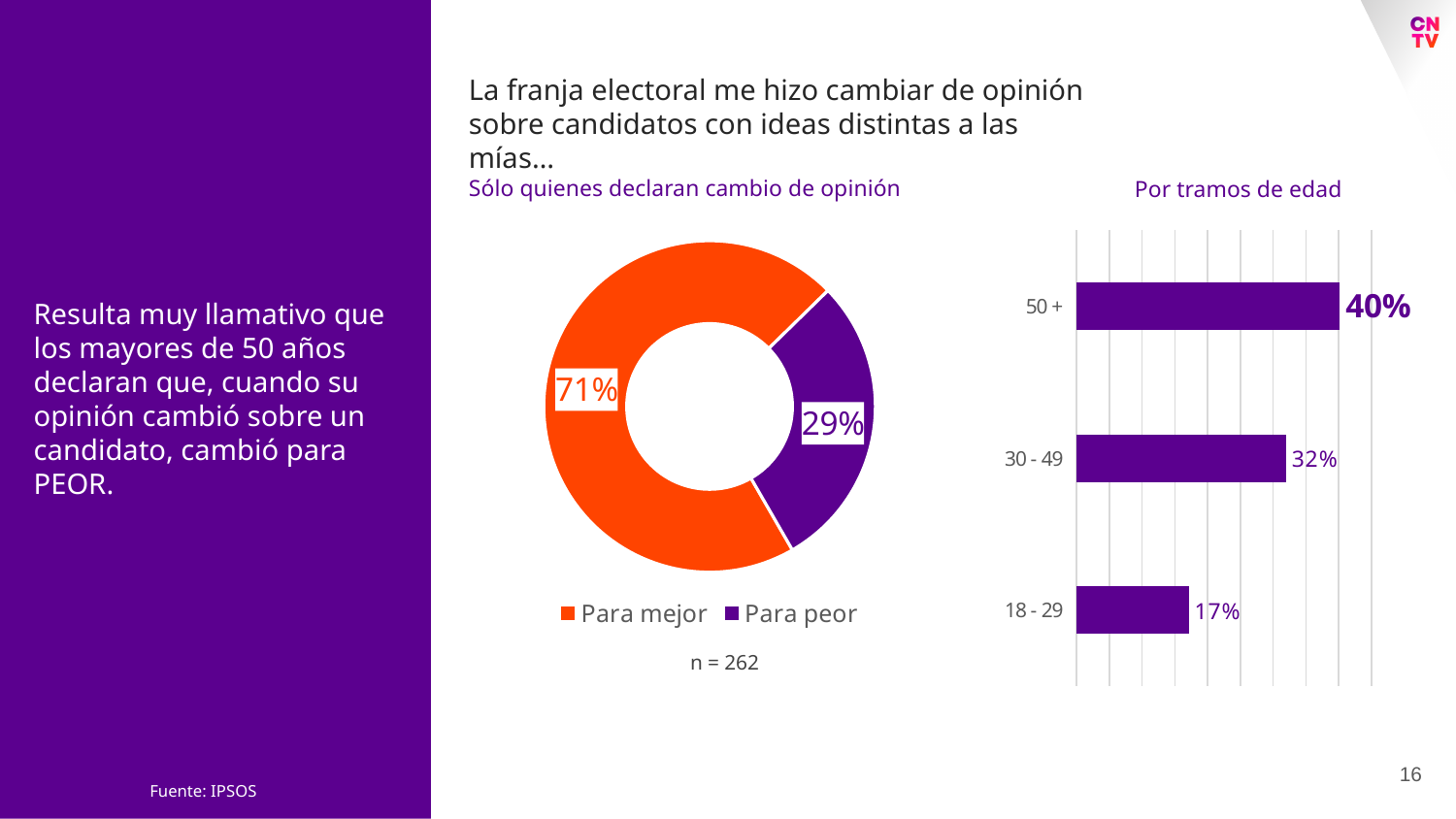
In the 'Por tramos de edad' chart on the right, which age group has the highest value? 50 + What kind of chart is the chart on the left of the slide? Donut (pie) chart In the 'Por tramos de edad' chart on the right, what is the difference between the 50 + and 18 - 29 values? 23% In the donut chart on the left, what share is labelled 'Para mejor'? 71% In the 'Por tramos de edad' chart on the right, what is the value for the 50 + age group? 40% In the 'Por tramos de edad' chart on the right, what is the value for the 30 - 49 age group? 32% In the donut chart on the left, what is the difference between the 'Para mejor' and 'Para peor' shares? 42% How many age groups are shown in the 'Por tramos de edad' chart on the right? 3 In the donut chart on the left, which category has the larger share, 'Para mejor' or 'Para peor'? Para mejor In the donut chart on the left, what share is labelled 'Para peor'? 29% How many entries does the legend of the donut chart on the left list? 2 In the 'Por tramos de edad' chart on the right, which age group has the lowest value? 18 - 29